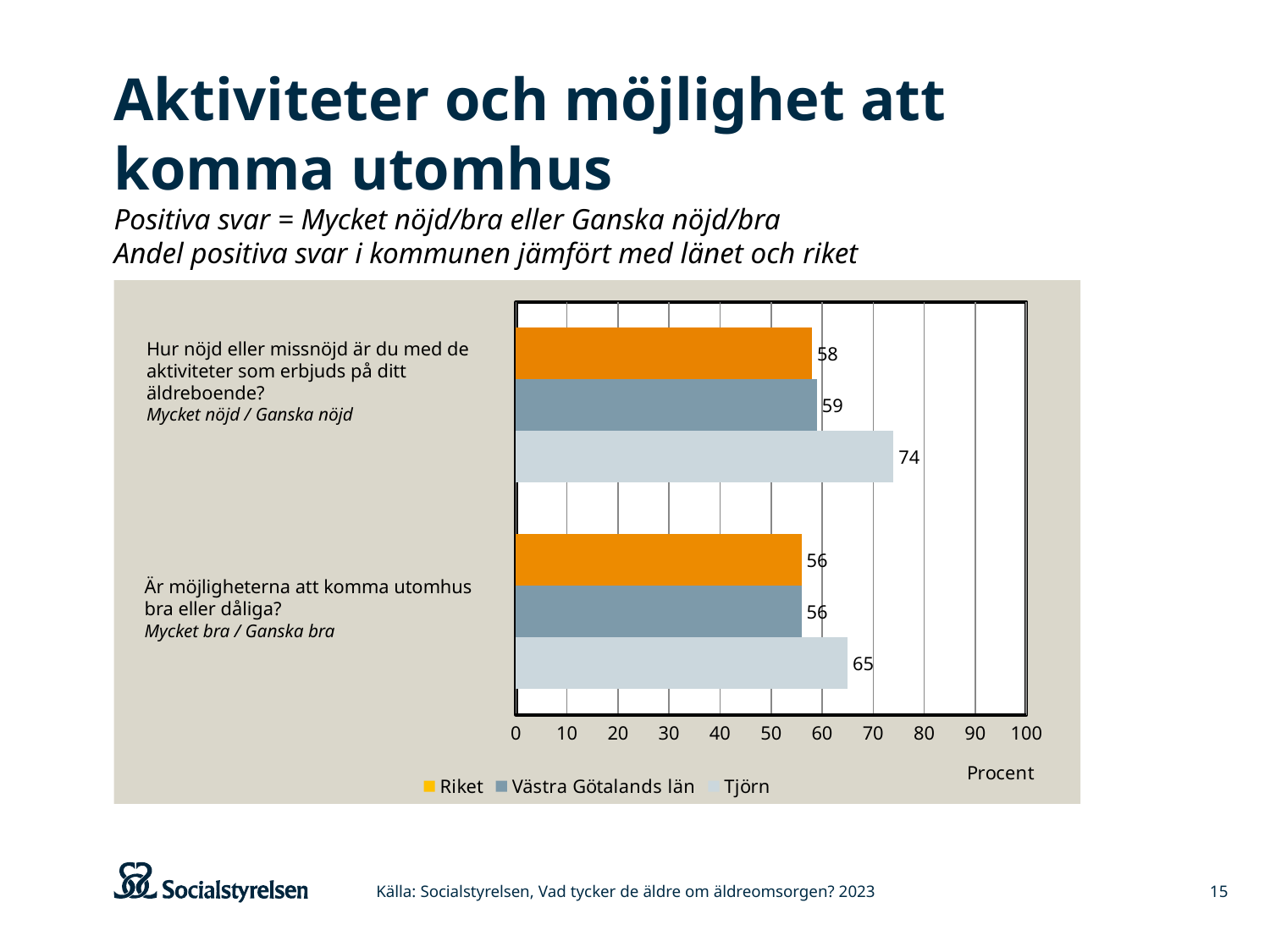
Which is larger: Tjörn's value for the activities question or Tjörn's value for the outdoors question? Tjörn's value for the activities question What is the difference between Tjörn and Västra Götalands län on the question about opportunities to get outdoors? 9 What unit is shown on the horizontal axis of the chart? Procent How many series does the legend list? 3 What is the value for Tjörn on the question about opportunities to get outdoors? 65 What is the difference between Tjörn and Riket on the question about activities offered at the elderly home? 16 What is the value for Tjörn on the question about activities offered at the elderly home (Hur nöjd eller missnöjd är du med de aktiviteter som erbjuds på ditt äldreboende?)? 74 Which series has the highest value on the question about activities offered at the elderly home? Tjörn What kind of chart is shown on the slide? Bar chart What is the value for Västra Götalands län on the question about activities offered at the elderly home? 59 Which series has the lowest value on the question about activities offered at the elderly home? Riket What is the value for Riket on the question about opportunities to get outdoors (Är möjligheterna att komma utomhus bra eller dåliga?)? 56